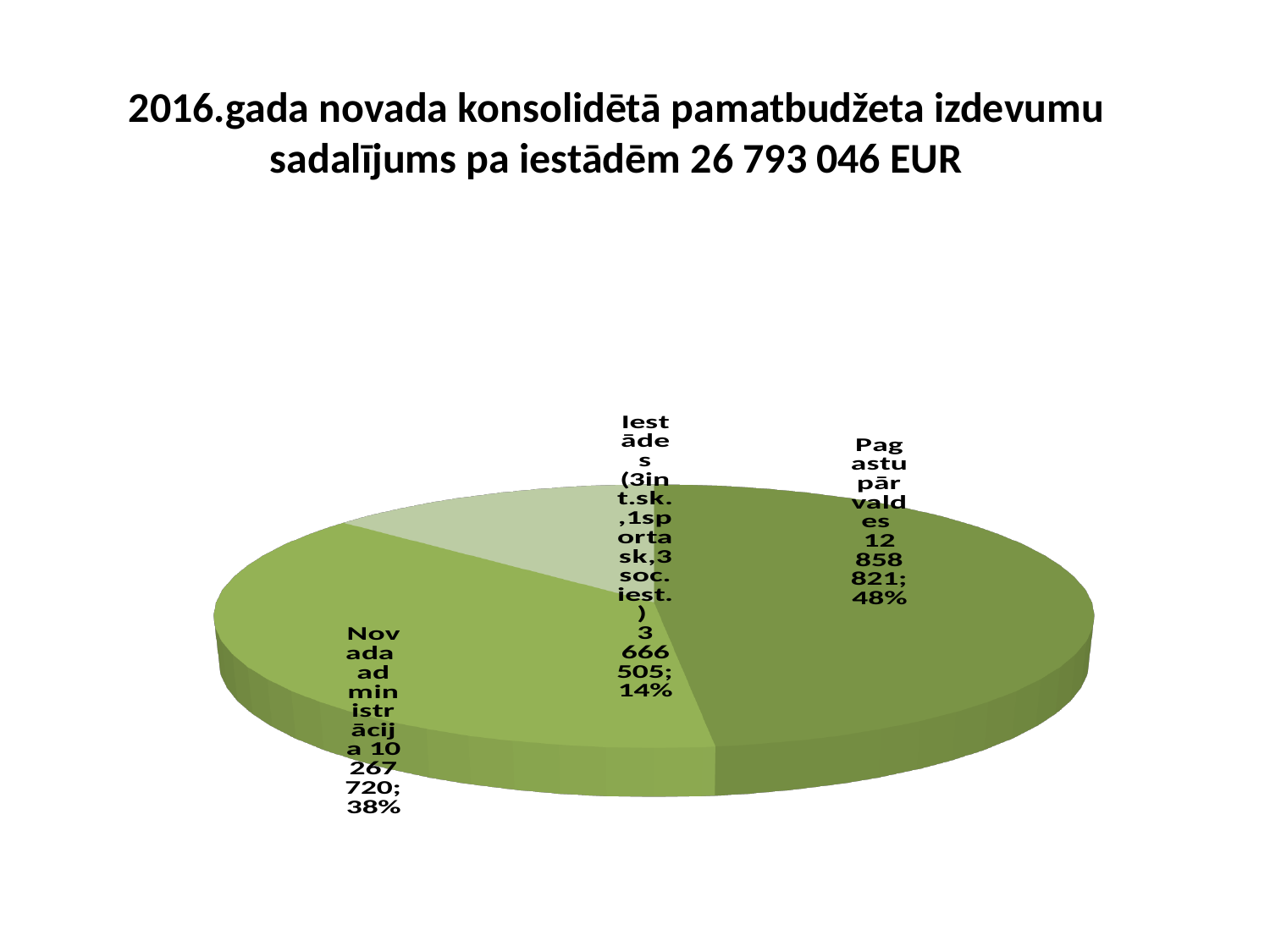
What is the value shown for Iestādes (3int.sk.,1sporta sk,3 soc. iest.)? 3 666 505 What total amount in EUR is stated in the chart title? 26 793 046 EUR What is the value shown for Pagastu pārvaldes? 12 858 821 Which slice is the smallest? Iestādes (3int.sk.,1sporta sk,3 soc. iest.) What is the difference between the values for Pagastu pārvaldes and Novada administrācija? 2 591 101 What share of the pie does Iestādes (3int.sk.,1sporta sk,3 soc. iest.) represent? 14% What share of the pie does Pagastu pārvaldes represent? 48% How many slices does the pie chart have? 3 Which slice is the largest? Pagastu pārvaldes What kind of chart is shown on the slide? pie chart What share of the pie does Novada administrācija represent? 38% What is the value shown for Novada administrācija? 10 267 720